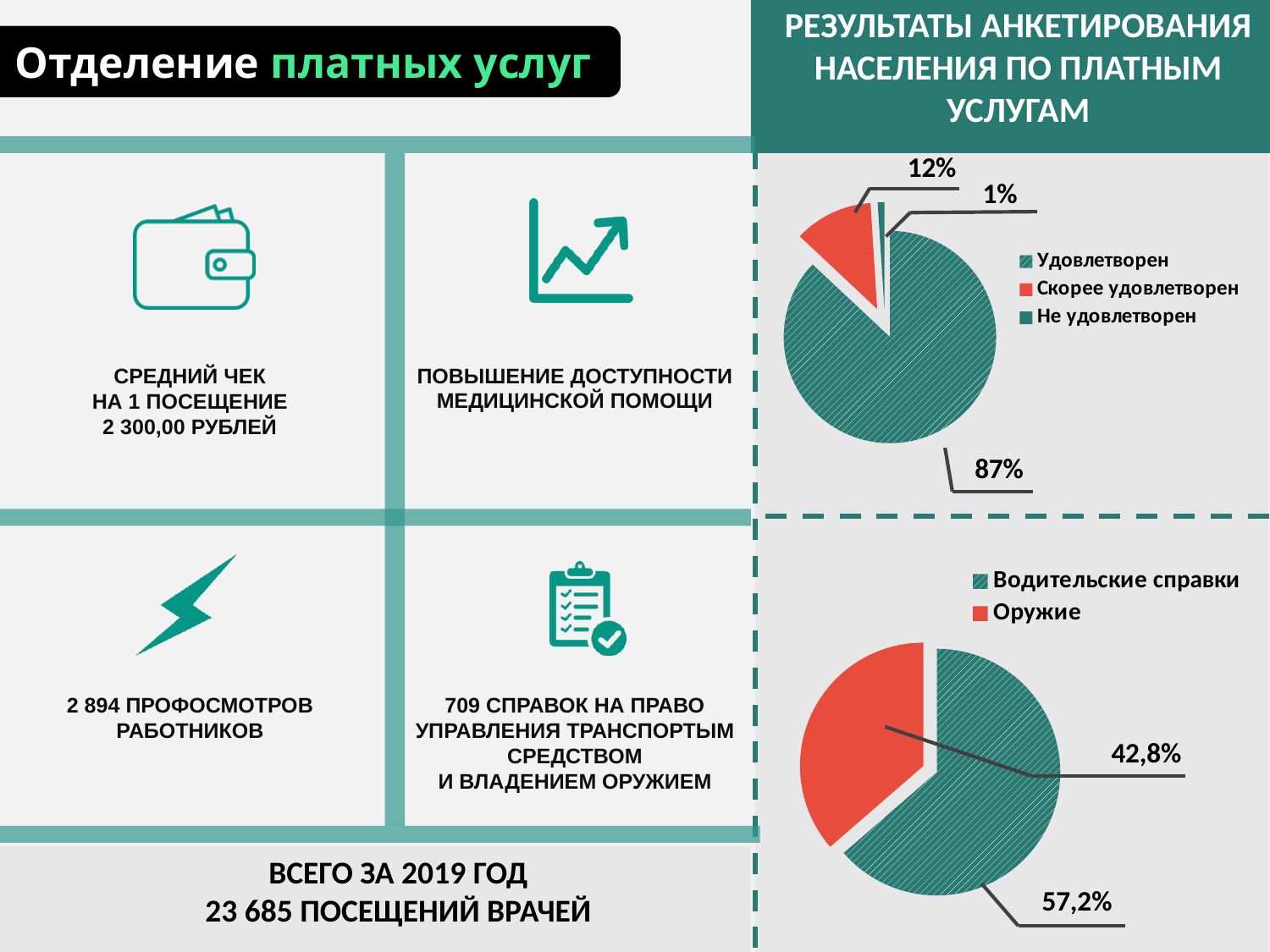
How many categories does the legend of the top pie chart list? 3 In the top pie chart, what is the difference between the shares for 'Удовлетворен' and 'Скорее удовлетворен'? 75% In the top pie chart (survey results on paid services), what share is labelled for 'Удовлетворен'? 87% In the bottom pie chart, what share is labelled for 'Оружие'? 42,8% In the top pie chart, what share is labelled for 'Скорее удовлетворен'? 12% What type of chart is the bottom chart on the right side of the slide? Pie chart In the bottom pie chart, what share is labelled for 'Водительские справки'? 57,2% In the top pie chart, which category has the largest slice? Удовлетворен In the top pie chart, what share is labelled for 'Не удовлетворен'? 1% In the top pie chart, which category has the smallest slice? Не удовлетворен In the bottom pie chart, which is larger: 'Водительские справки' or 'Оружие'? Водительские справки In the bottom pie chart, what is the difference between the shares for 'Водительские справки' and 'Оружие'? 14,4%